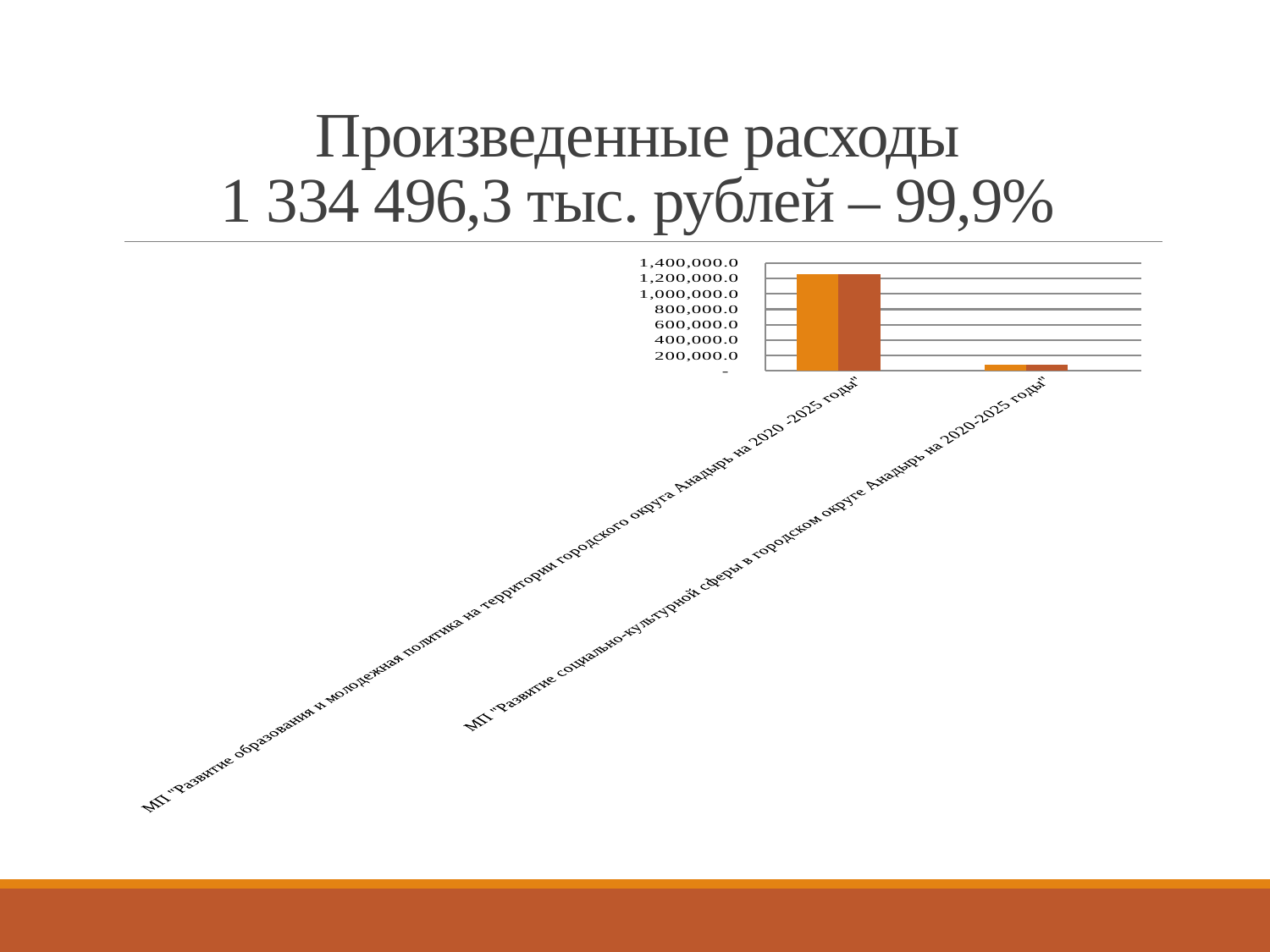
Are the values for МП "Развитие социально-культурной сферы..." greater or less than 200,000.0? less Which category has the lowest bars in the chart? МП "Развитие социально-культурной сферы в городском округе Анадырь на 2020-2025 годы" How many categories are shown on the x axis of the chart? 2 Which category has larger values: МП "Развитие образования и молодежная политика..." or МП "Развитие социально-культурной сферы..."? МП "Развитие образования и молодежная политика на территории городского округа Анадырь на 2020 -2025 годы" What is the highest value shown on the y axis of the chart? 1,400,000.0 How many bars are drawn for each category in the chart? 2 Do the values rise or fall from the first category to the second along the x axis? fall Which category has the highest bars in the chart? МП "Развитие образования и молодежная политика на территории городского округа Анадырь на 2020 -2025 годы" What kind of chart is shown on the slide? bar chart Are the values for МП "Развитие образования и молодежная политика..." greater or less than 1,000,000.0? greater Are the values for МП "Развитие образования и молодежная политика..." greater or less than 1,400,000.0? less